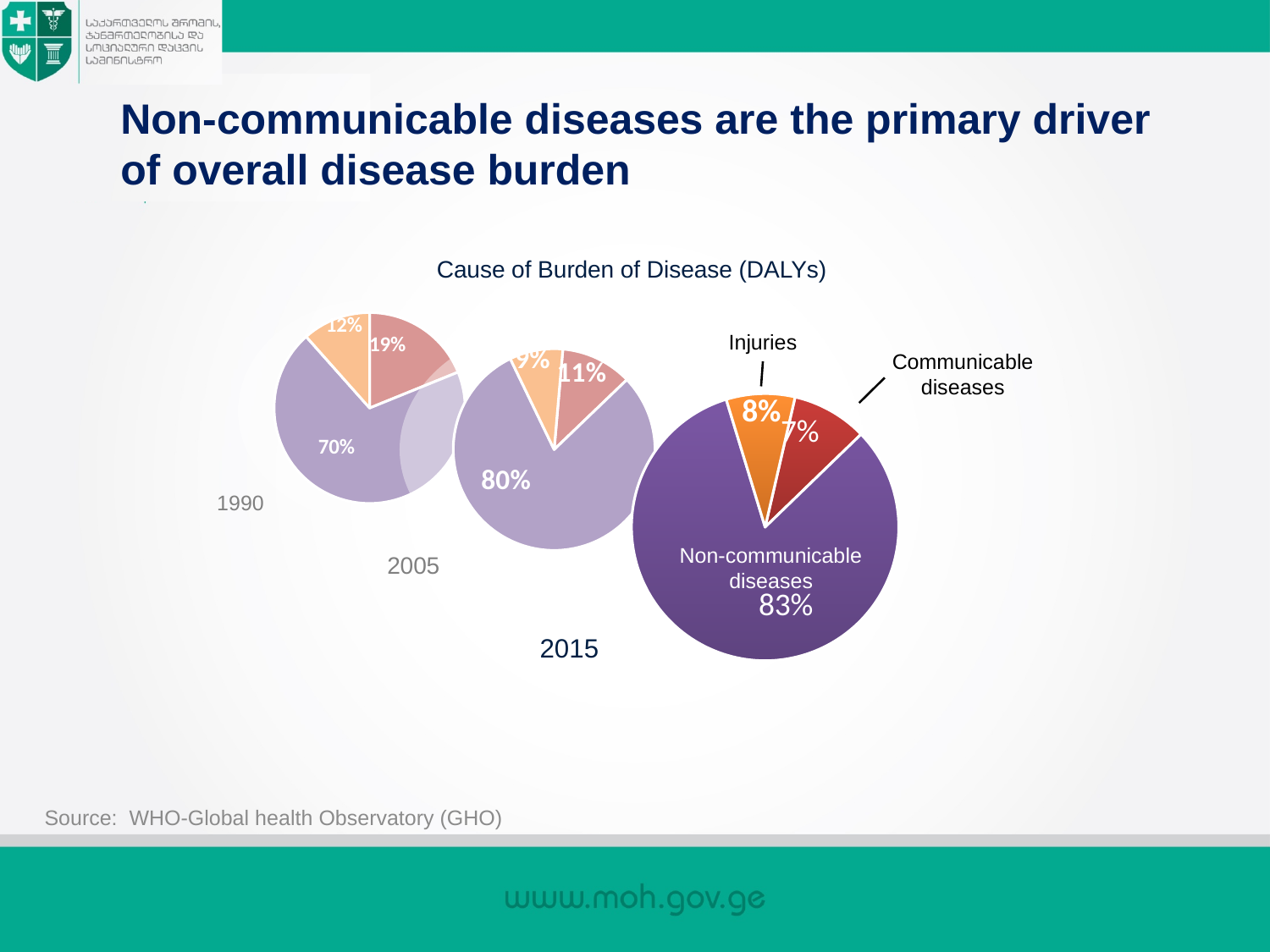
What is the difference between the largest slice in the 2015 pie chart and the largest slice in the 1990 pie chart? 13 percentage points In the 2015 pie chart, which category has the largest slice? Non-communicable diseases In the 2015 pie chart, what share is attributed to injuries? 8% In the 2015 pie chart, which category has the smallest slice? Communicable diseases In the 2015 pie chart, how many slices are there? 3 How many pie charts are shown on the slide? 3 In the 2015 pie chart, what share is attributed to communicable diseases? 7% What kind of charts are shown on the slide under the title 'Cause of Burden of Disease (DALYs)'? Pie charts What is the largest percentage shown in the 2005 pie chart? 80% How does the largest slice change from the 1990 pie chart to the 2015 pie chart? It rises (70% to 83%) What is the largest percentage shown in the 1990 pie chart? 70% In the 2015 pie chart, what share of the burden of disease is attributed to non-communicable diseases? 83%